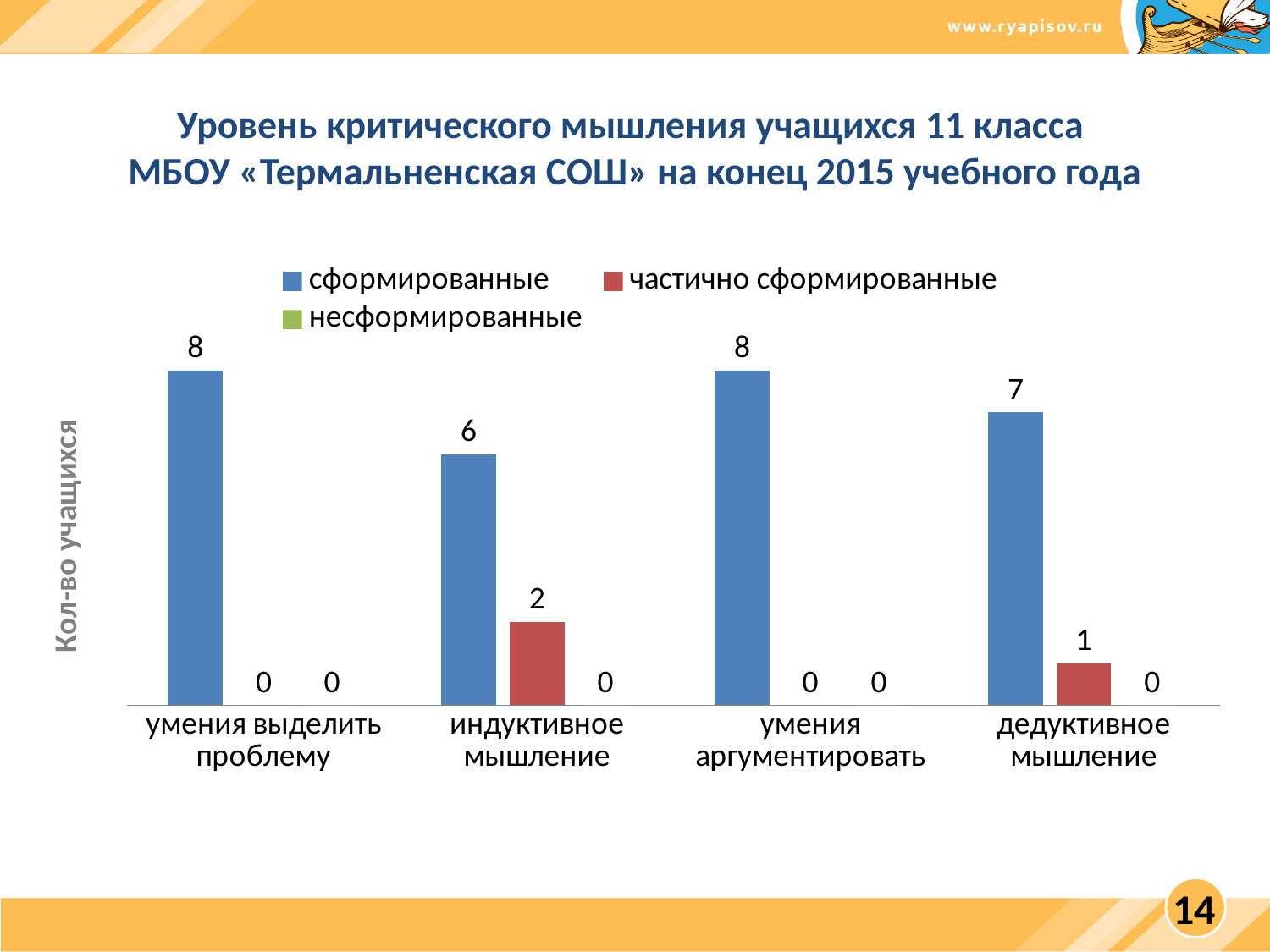
Which is larger: the 'сформированные' value for 'индуктивное мышление' or for 'дедуктивное мышление'? дедуктивное мышление How many categories are shown on the x axis? 4 What is the value for 'частично сформированные' in the 'индуктивное мышление' category? 2 What is the value for 'сформированные' in the 'умения аргументировать' category? 8 How many series does the legend list? 3 What kind of chart is shown on the slide? bar chart What is the label of the vertical axis? Кол-во учащихся What is the value for 'сформированные' in the 'индуктивное мышление' category? 6 What is the value for 'частично сформированные' in the 'дедуктивное мышление' category? 1 Which category has the highest value for the 'частично сформированные' series? индуктивное мышление What is the difference between the 'сформированные' values for 'умения выделить проблему' and 'дедуктивное мышление'? 1 Which category has the lowest value for the 'сформированные' series? индуктивное мышление